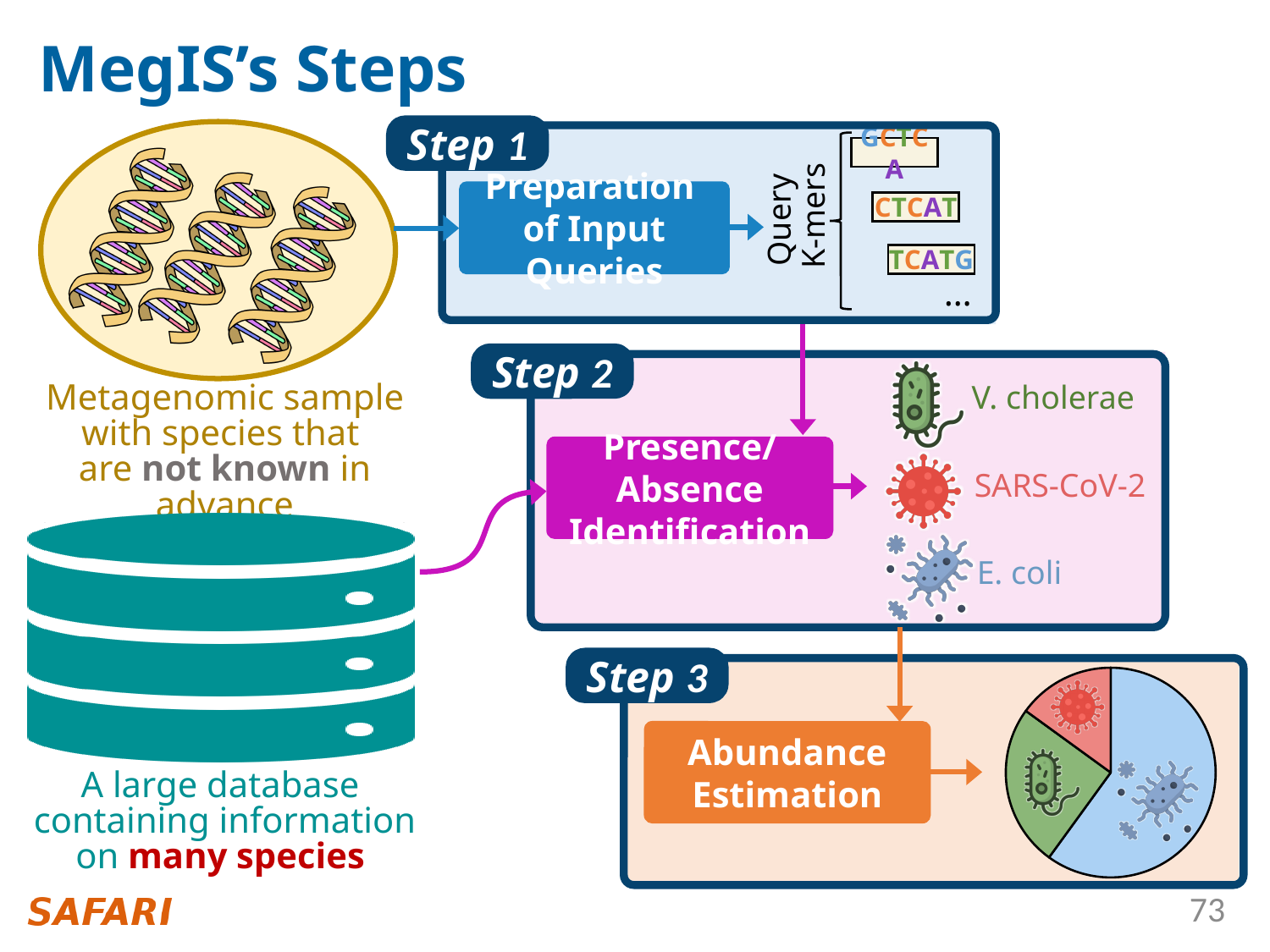
What kind of chart is shown in the Step 3 box of the slide? pie chart Which step's box on the slide contains the pie chart? Step 3 What is the label of the orange box that points to the pie chart in Step 3? Abundance Estimation In the pie chart in the Step 3 box, does the blue slice take up more or less than half of the pie? more In the pie chart in the Step 3 box, which colour slice is the largest? blue In the pie chart in the Step 3 box, is the blue slice larger or smaller than the red slice? larger How many slices does the pie chart in the Step 3 box have? 3